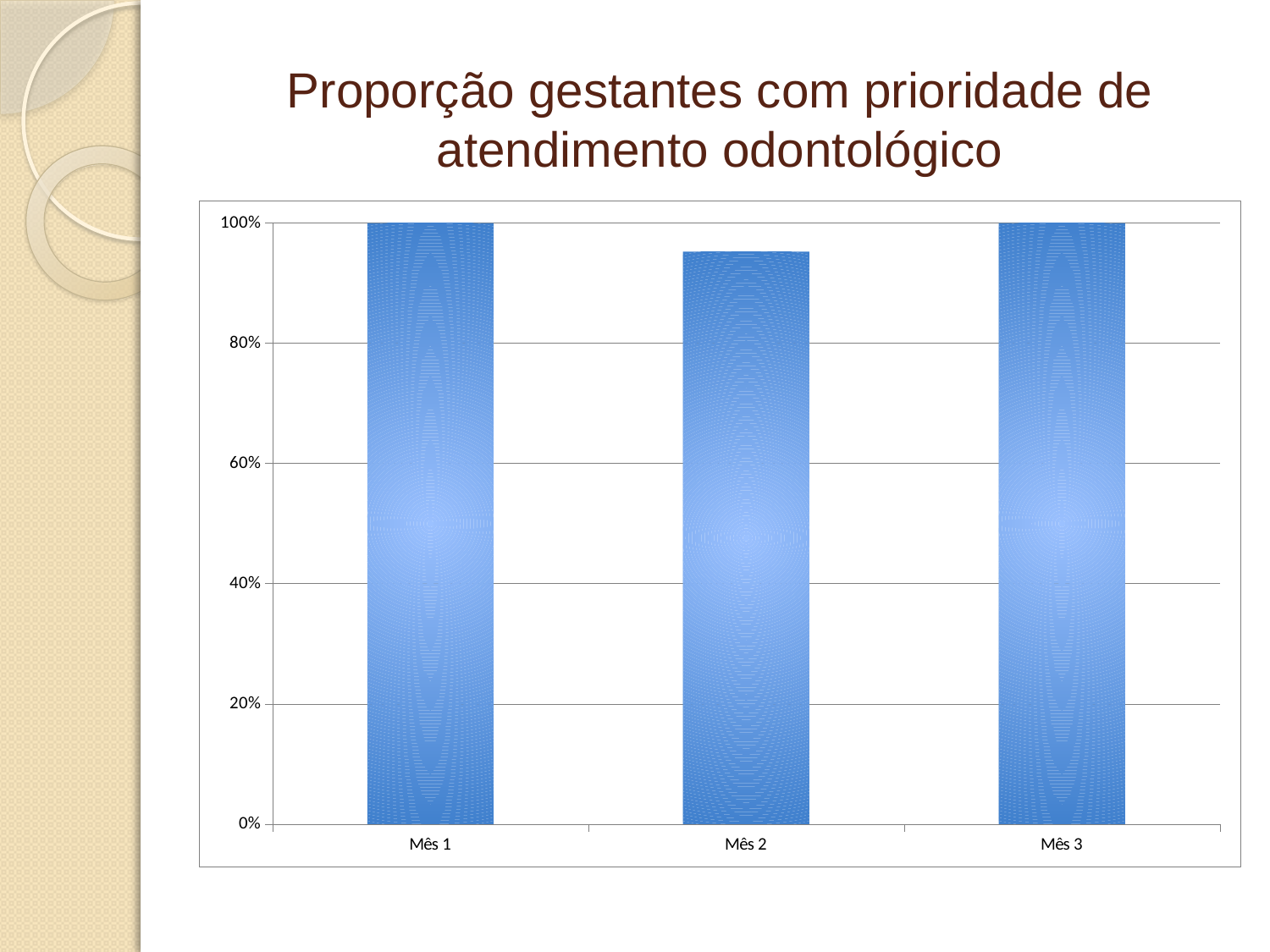
Is the value for Mês 2 greater or less than 100%? less What is the title of the slide? Proporção gestantes com prioridade de atendimento odontológico Which is larger, the value for Mês 1 or the value for Mês 2? Mês 1 How many months are shown on the x axis? 3 Which is larger, the value for Mês 2 or the value for Mês 3? Mês 3 Which month has the lowest value? Mês 2 Is the value for Mês 2 greater or less than 80%? greater What kind of chart is shown on the slide? bar chart What is the value for Mês 3? 100% From Mês 1 to Mês 2, does the value rise or fall? fall From Mês 2 to Mês 3, does the value rise or fall? rise What is the value for Mês 1? 100%